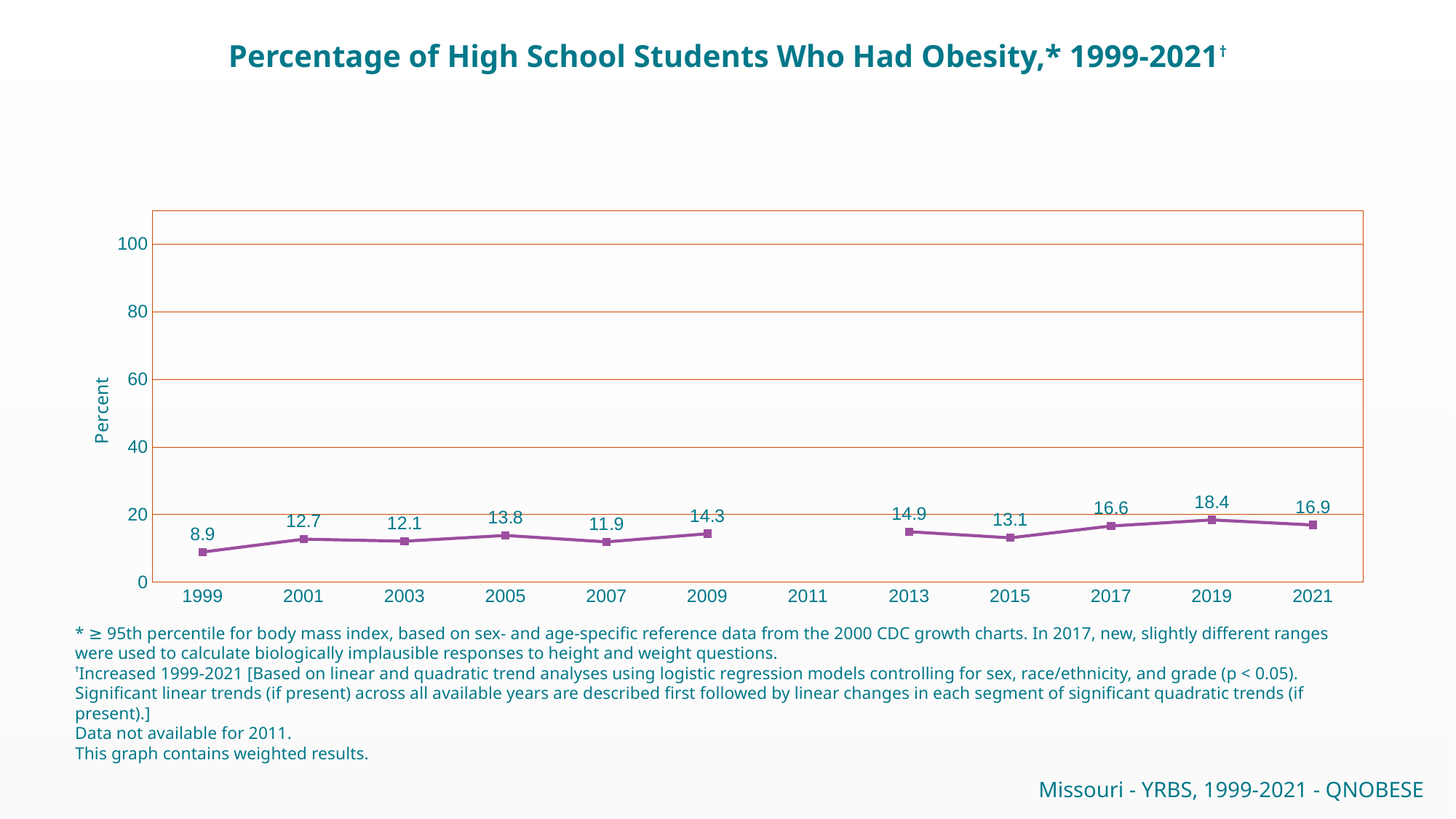
Which year has the lowest percentage of students who had obesity? 1999 What is the value plotted for 2019? 18.4 Which year has the highest percentage of students who had obesity? 2019 What is the difference between the 2019 value and the 2017 value? 1.8 Is the value for 2021 greater or less than 20? less What percentage of high school students had obesity in 1999? 8.9 How many years have a data point plotted on the chart? 11 What is the difference between the 2021 value and the 1999 value? 8 What kind of chart is shown on the slide? Line chart Which year has a larger value, 2007 or 2009? 2009 Which year on the x axis has no data plotted? 2011 What is the value plotted for 2013? 14.9